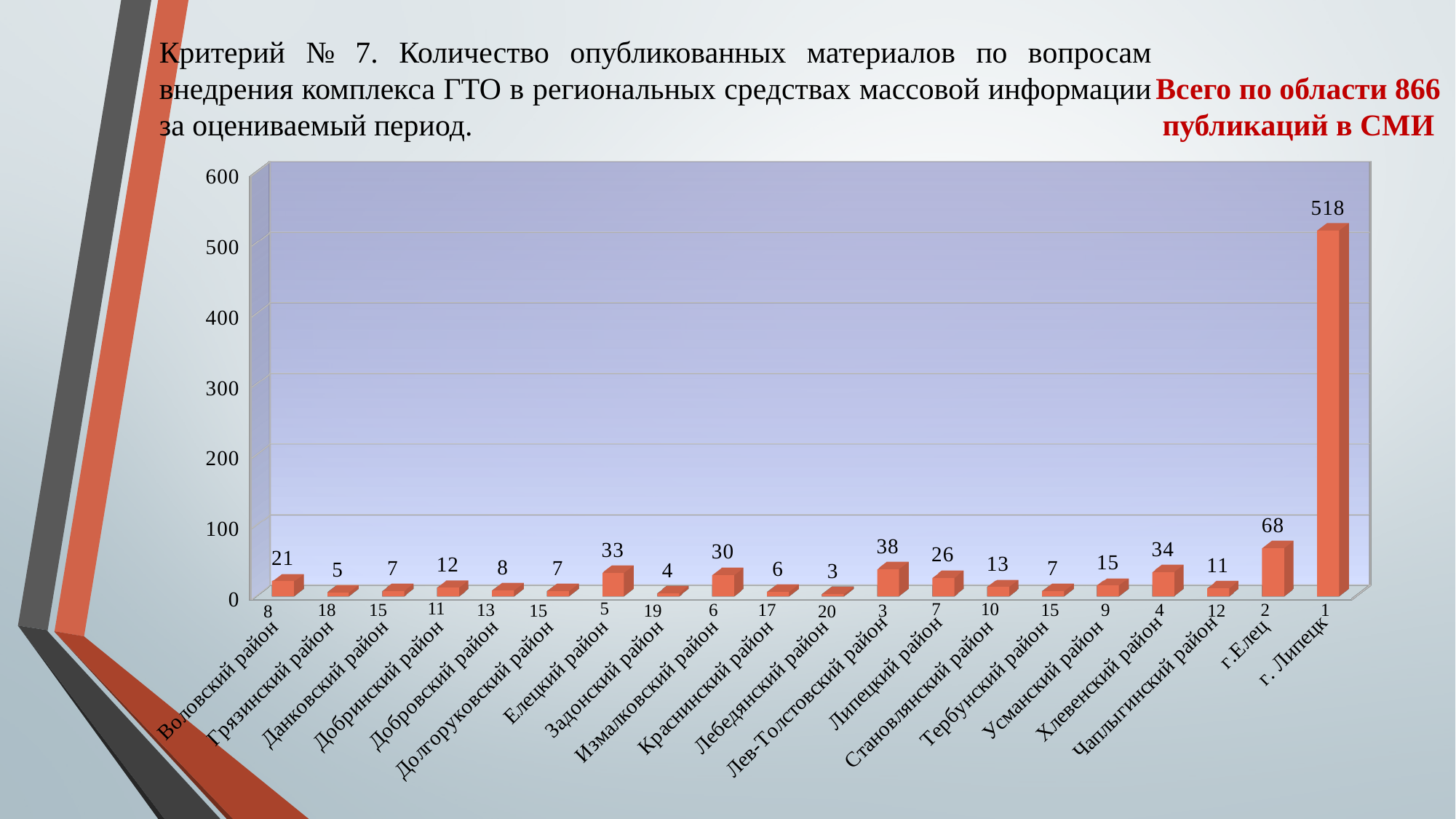
What total number of publications for the region is stated in red text on the slide? 866 Which is larger, the value for Елецкий район or the value for Измалковский район? Елецкий район What is the value for г. Липецк? 518 Which category has the lowest value? Лебедянский район What kind of chart is shown on the slide? bar chart Is the value for г. Липецк greater or less than 500? greater What is the difference between the values for г. Липецк and г.Елец? 450 What is the value for г.Елец? 68 What is the value for Лев-Толстовский район? 38 How many categories are shown on the x axis? 20 Which category has the highest value? г. Липецк What is the value for Воловский район? 21